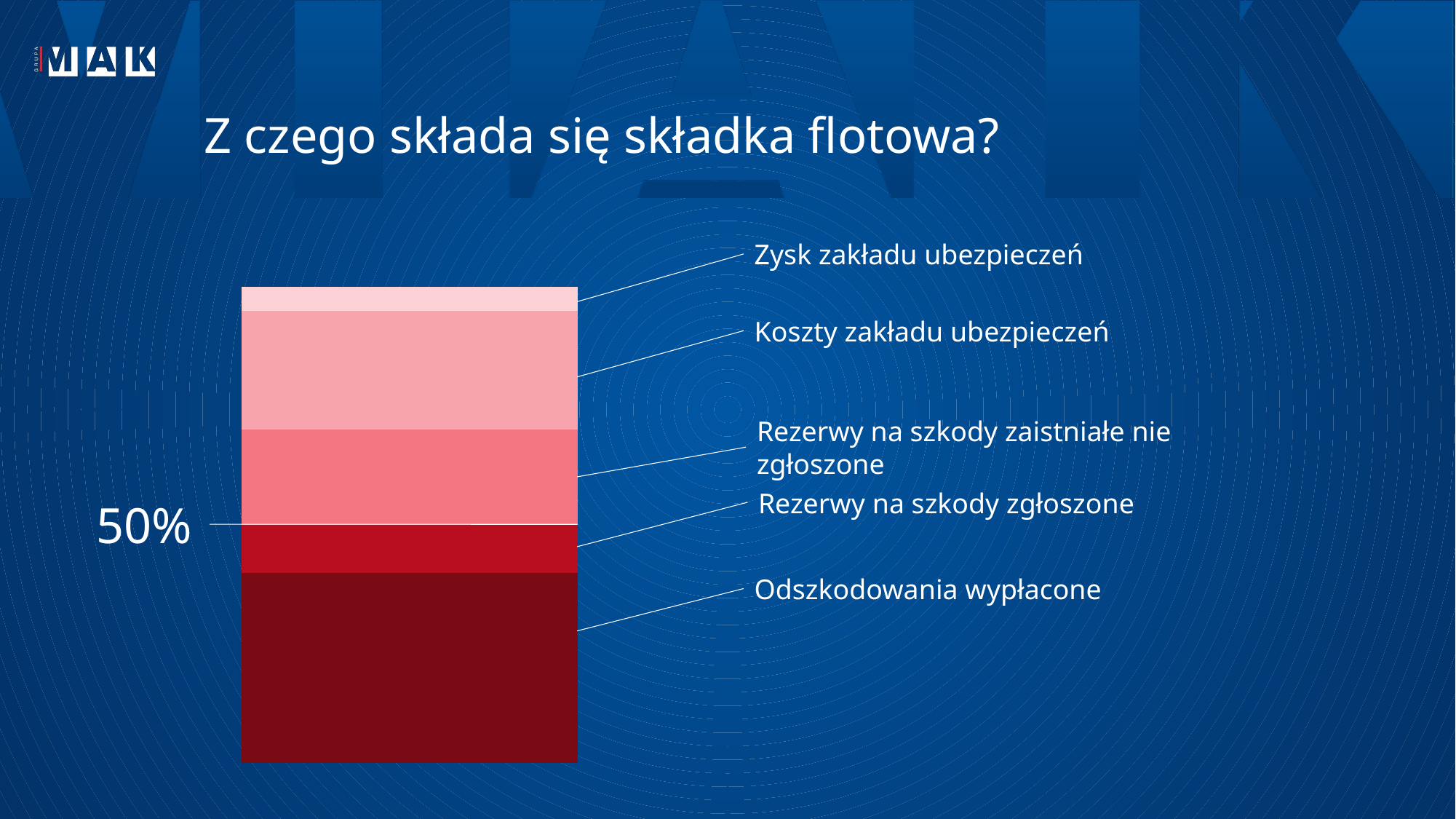
Which segment of the bar is the largest? Odszkodowania wypłacone Is the Odszkodowania wypłacone segment alone greater or less than 50% of the bar? less Which segment is larger: Koszty zakładu ubezpieczeń or Rezerwy na szkody zgłoszone? Koszty zakładu ubezpieczeń What is the title of the slide containing the chart? Z czego składa się składka flotowa? Which segment is at the bottom of the stacked bar? Odszkodowania wypłacone Which segment sits directly above the 50% line? Rezerwy na szkody zaistniałe nie zgłoszone What kind of chart is shown on the slide? Stacked bar chart What percentage value is marked on the left of the bar? 50% How many segments make up the stacked bar? 5 Which segment is larger: Odszkodowania wypłacone or Rezerwy na szkody zaistniałe nie zgłoszone? Odszkodowania wypłacone Which segment of the bar is the smallest? Zysk zakładu ubezpieczeń Which segment is larger: Zysk zakładu ubezpieczeń or Rezerwy na szkody zgłoszone? Rezerwy na szkody zgłoszone